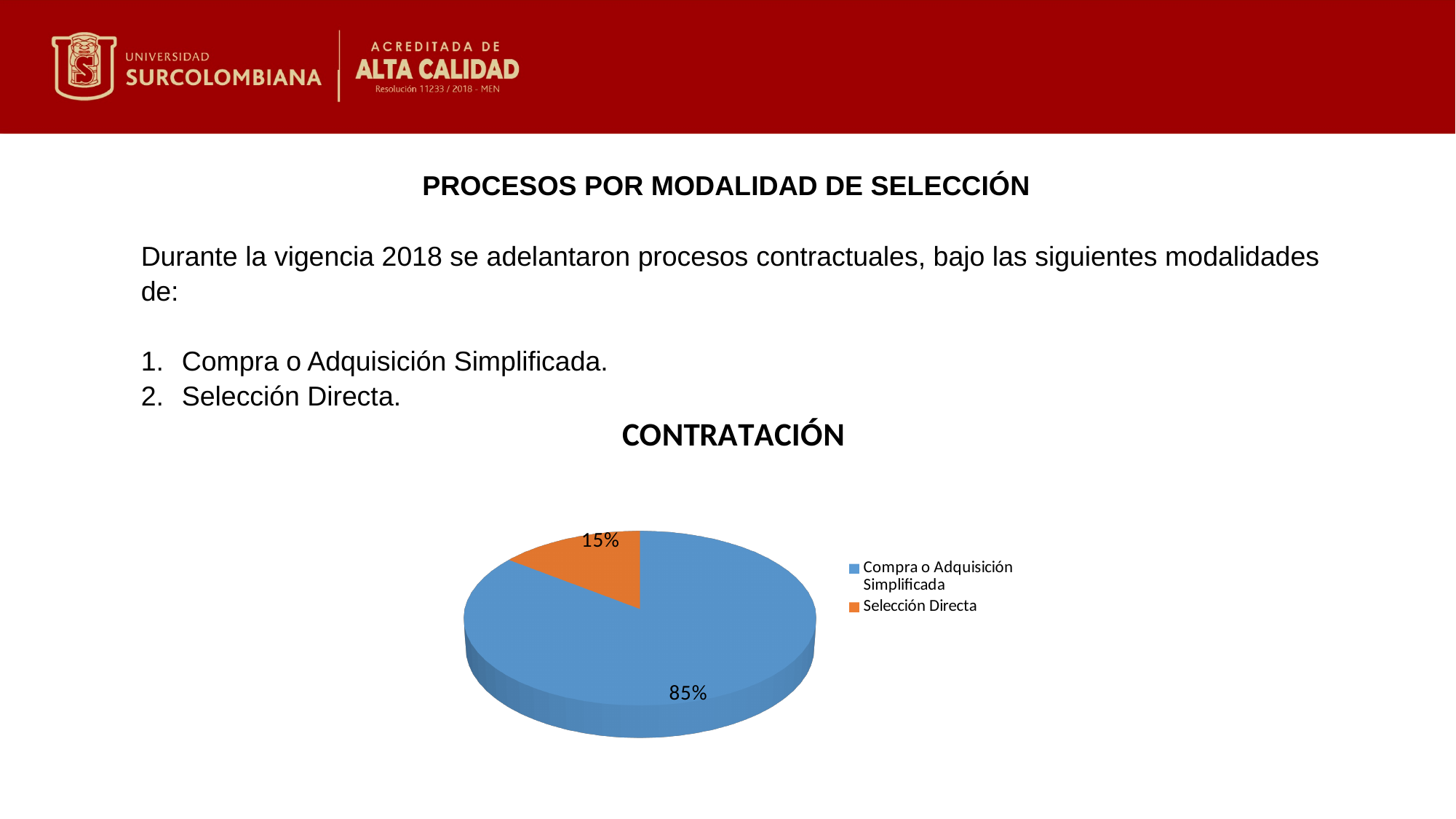
What colour is the slice for Selección Directa? Orange How many entries does the legend list? 2 How many categories does the pie chart show? 2 What type of chart is shown under the title CONTRATACIÓN? Pie chart What is the title of the chart? CONTRATACIÓN What share of the pie does Selección Directa represent? 15% What share of the pie does Compra o Adquisición Simplificada represent? 85% Which category has the largest slice of the pie? Compra o Adquisición Simplificada Which category has the smallest slice of the pie? Selección Directa What is the difference in percentage points between Compra o Adquisición Simplificada and Selección Directa? 70 Which is larger, the slice for Selección Directa or the slice for Compra o Adquisición Simplificada? Compra o Adquisición Simplificada